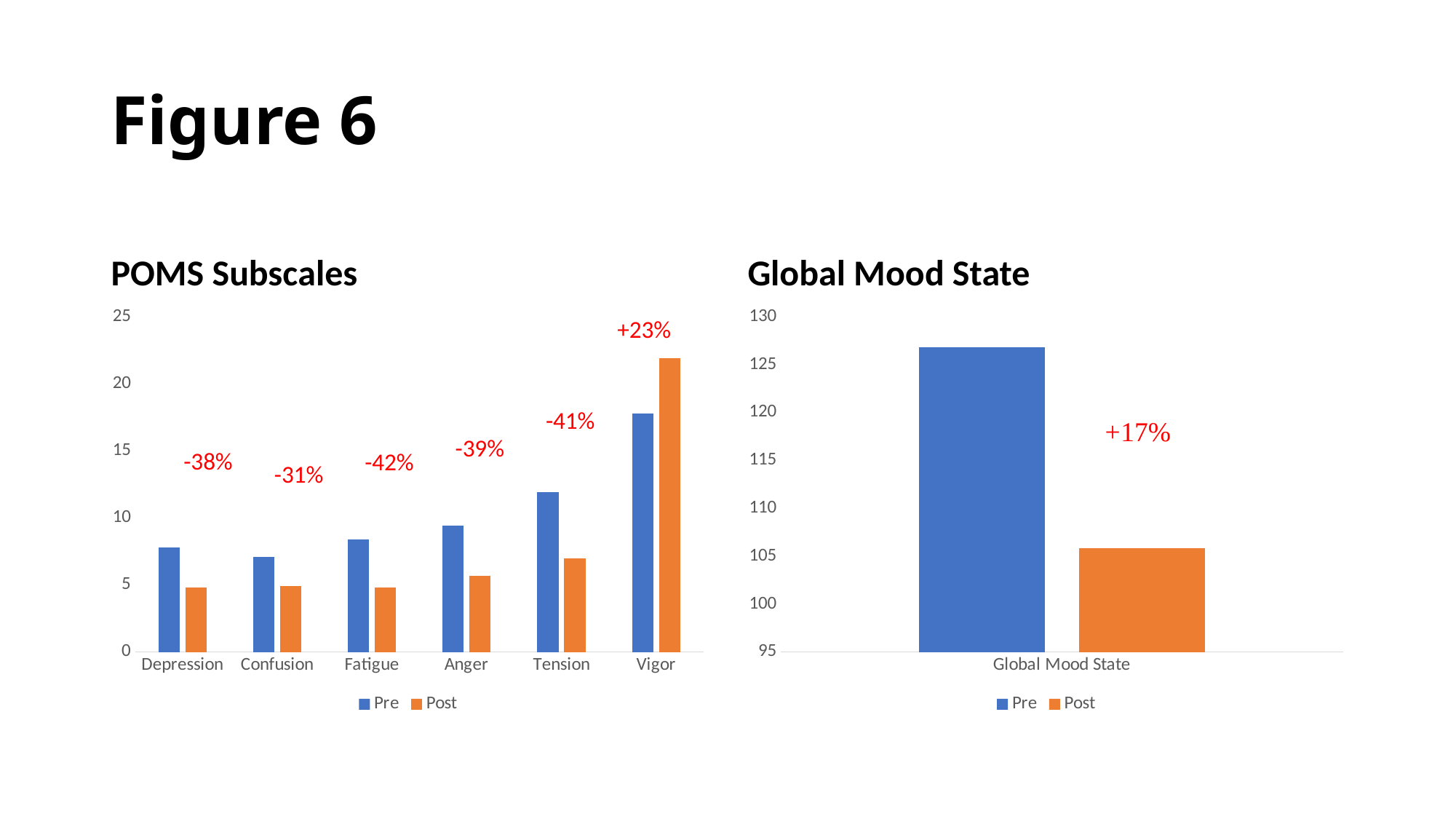
On the POMS Subscales chart, what percentage change is shown above the Fatigue bars? -42% How many categories are shown on the x axis of the POMS Subscales chart? 6 On the POMS Subscales chart, which colour represents the Post series? Orange On the Global Mood State chart, is the Post value greater or less than 110? less On the POMS Subscales chart, what percentage change is shown for Vigor? +23% On the Global Mood State chart, what percentage change is printed in red? +17% How many series does the legend of the Global Mood State chart list? 2 On the POMS Subscales chart, is the Post value for Vigor greater or less than 20? greater On the POMS Subscales chart, is the Pre or the Post bar larger for Tension? Pre On the Global Mood State chart, is the Pre value greater or less than 125? greater On the POMS Subscales chart, which category has the tallest bar? Vigor What kind of chart is the POMS Subscales chart? Bar chart